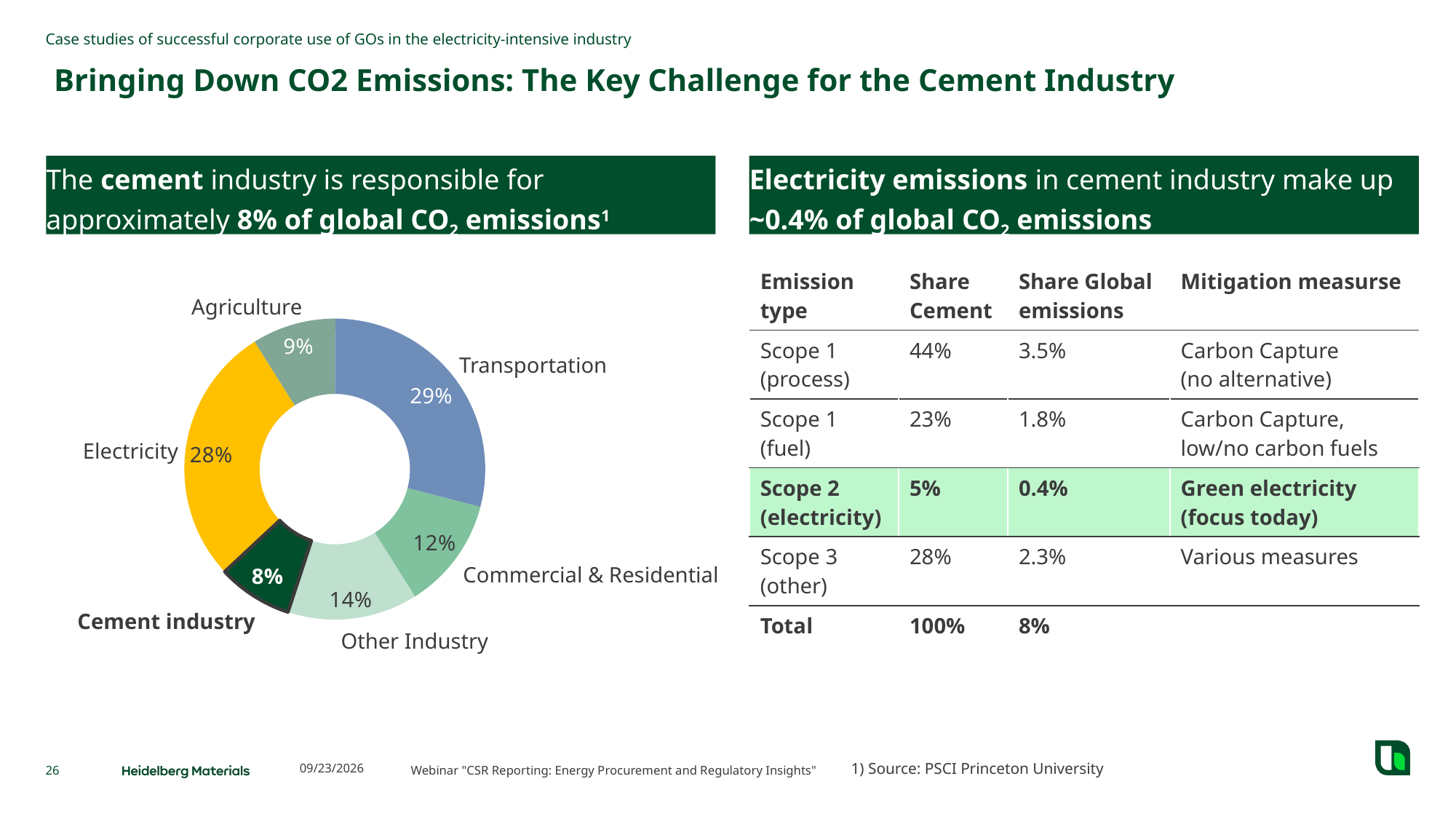
What value is labelled on the Other Industry slice of the donut chart? 14% What type of chart is used to show the breakdown of global CO2 emissions? Donut (pie) chart Which category has the largest slice in the donut chart? Transportation In the donut chart, which is larger: Other Industry or Agriculture? Other Industry How many categories are shown in the donut chart? 6 What value does the donut chart show for Electricity? 28% In the donut chart, what is the combined share of Transportation and Electricity? 57% What share of global CO2 emissions does the donut chart attribute to Transportation? 29% Which category has the smallest slice in the donut chart? Cement industry Which slice of the donut chart is drawn in dark green and labelled in bold? Cement industry In the donut chart, what is the difference between the Electricity share and the Commercial & Residential share? 16% What percentage is shown for the Cement industry slice in the donut chart? 8%